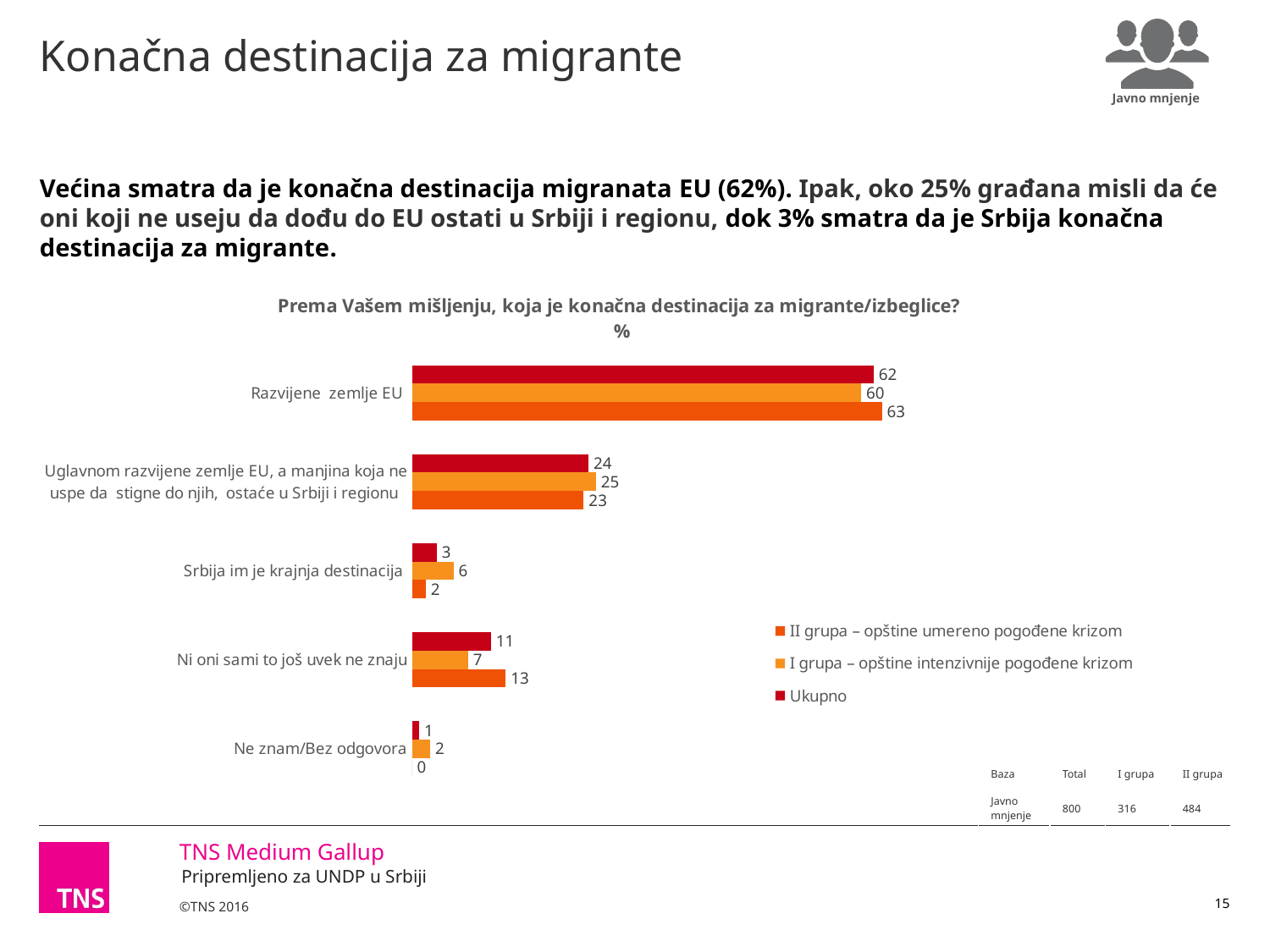
What is the difference between the Ukupno values for "Razvijene zemlje EU" and "Uglavnom razvijene zemlje EU, a manjina koja ne uspe da stigne do njih, ostaće u Srbiji i regionu"? 38 How many categories are shown on the chart? 5 What is the value for "I grupa – opštine intenzivnije pogođene krizom" in the category "Srbija im je krajnja destinacija"? 6 What is the title of the chart? Prema Vašem mišljenju, koja je konačna destinacija za migrante/izbeglice? % For "Ni oni sami to još uvek ne znaju", which is larger: the Ukupno value or the I grupa value? Ukupno How many series does the legend list? 3 Which category has the lowest value for "II grupa – opštine umereno pogođene krizom"? Ne znam/Bez odgovora What kind of chart is shown on the slide? Bar chart What is the difference between the II grupa and I grupa values for "Razvijene zemlje EU"? 3 What is the value for "II grupa – opštine umereno pogođene krizom" in the category "Ni oni sami to još uvek ne znaju"? 13 Which category has the highest Ukupno value? Razvijene zemlje EU What is the Ukupno value for "Razvijene zemlje EU"? 62